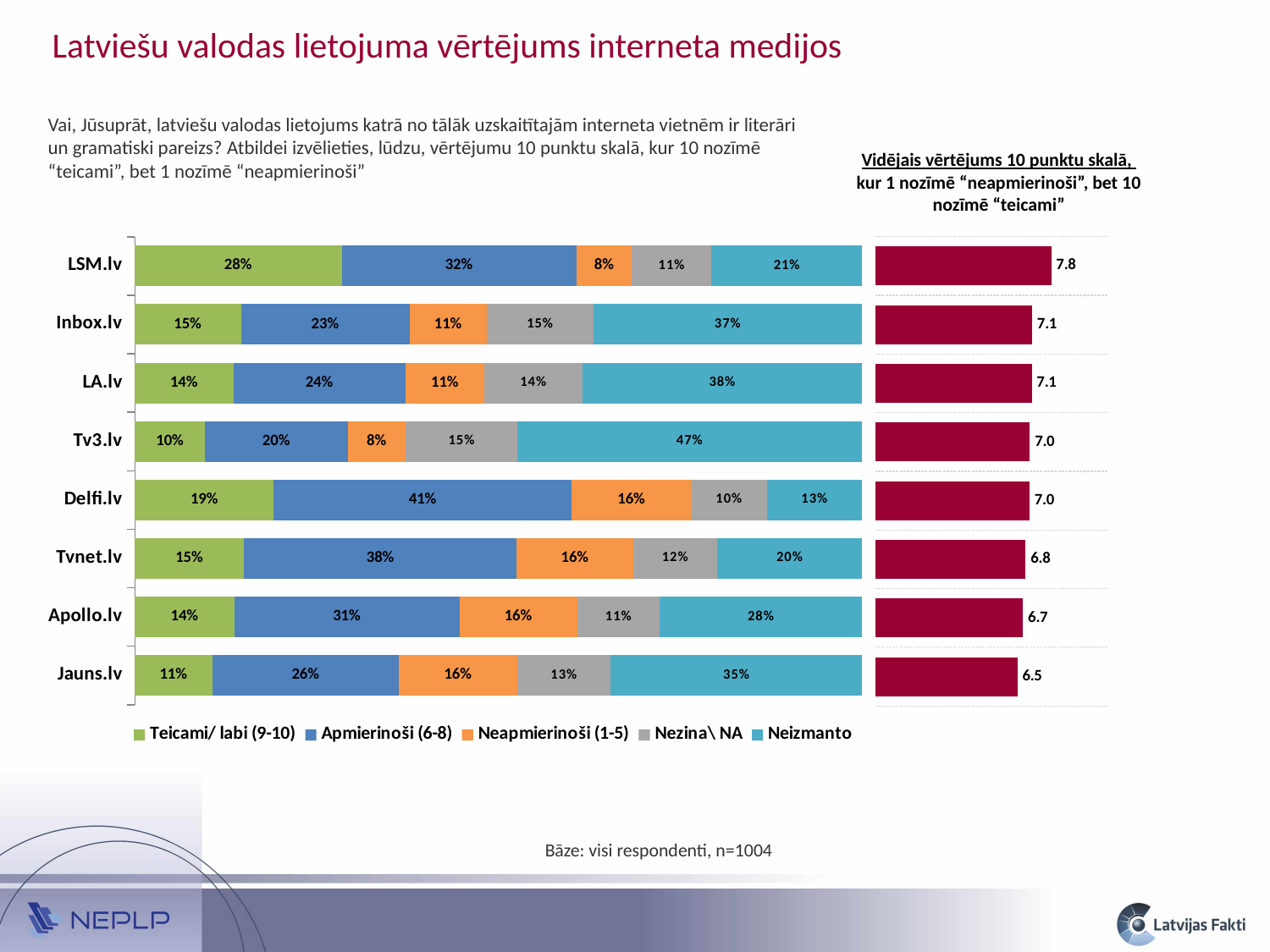
In the stacked bar chart on the left, which is larger: the "Neizmanto" share for Delfi.lv or for Apollo.lv? Apollo.lv In the stacked bar chart on the left, what percentage of respondents rated LSM.lv as "Teicami/ labi (9-10)"? 28% How many series does the legend of the stacked bar chart on the left list? 5 What kind of chart is the chart on the left? Stacked bar chart How many websites are shown in the stacked bar chart on the left? 8 In the average score chart on the right, which website has the lowest average rating? Jauns.lv In the average score chart on the right, what is the average rating for Tvnet.lv? 6.8 In the stacked bar chart on the left, what is the "Neapmierinoši (1-5)" share for Inbox.lv? 11% In the stacked bar chart on the left, what is the "Neizmanto" share for Tv3.lv? 47% In the average score chart on the right, which website has the highest average rating? LSM.lv In the average score chart on the right, what is the difference between the average ratings of LSM.lv and Jauns.lv? 1.3 In the stacked bar chart on the left, which website has the highest "Apmierinoši (6-8)" share? Delfi.lv